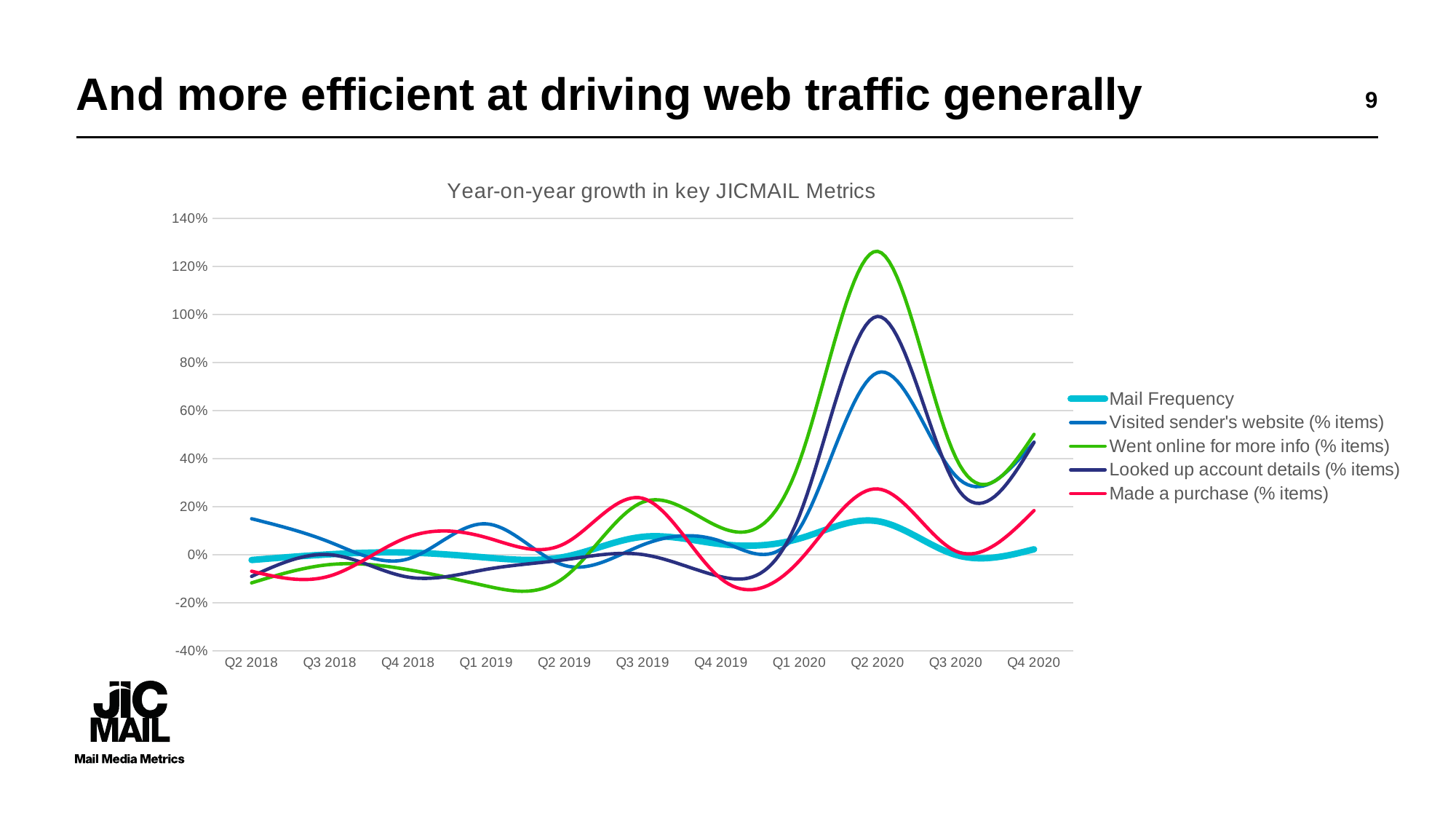
Which series has the highest value in Q2 2020? Went online for more info (% items) Is the value for 'Went online for more info (% items)' in Q2 2020 greater or less than 120%? greater Is the value for 'Mail Frequency' in Q2 2020 greater or less than 20%? less Does the 'Went online for more info (% items)' series rise or fall from Q2 2020 to Q3 2020? Fall How many quarters are shown along the x axis? 11 Is the value for 'Visited sender's website (% items)' in Q2 2020 greater or less than 80%? less In Q4 2020, which is larger: 'Went online for more info (% items)' or 'Made a purchase (% items)'? Went online for more info (% items) How many series does the legend list? 5 In which quarter is the 'Made a purchase (% items)' series at its lowest? Q4 2019 What is the title of the chart? Year-on-year growth in key JICMAIL Metrics What kind of chart is shown on the slide? Line chart In which quarter does the 'Went online for more info (% items)' series reach its highest value? Q2 2020